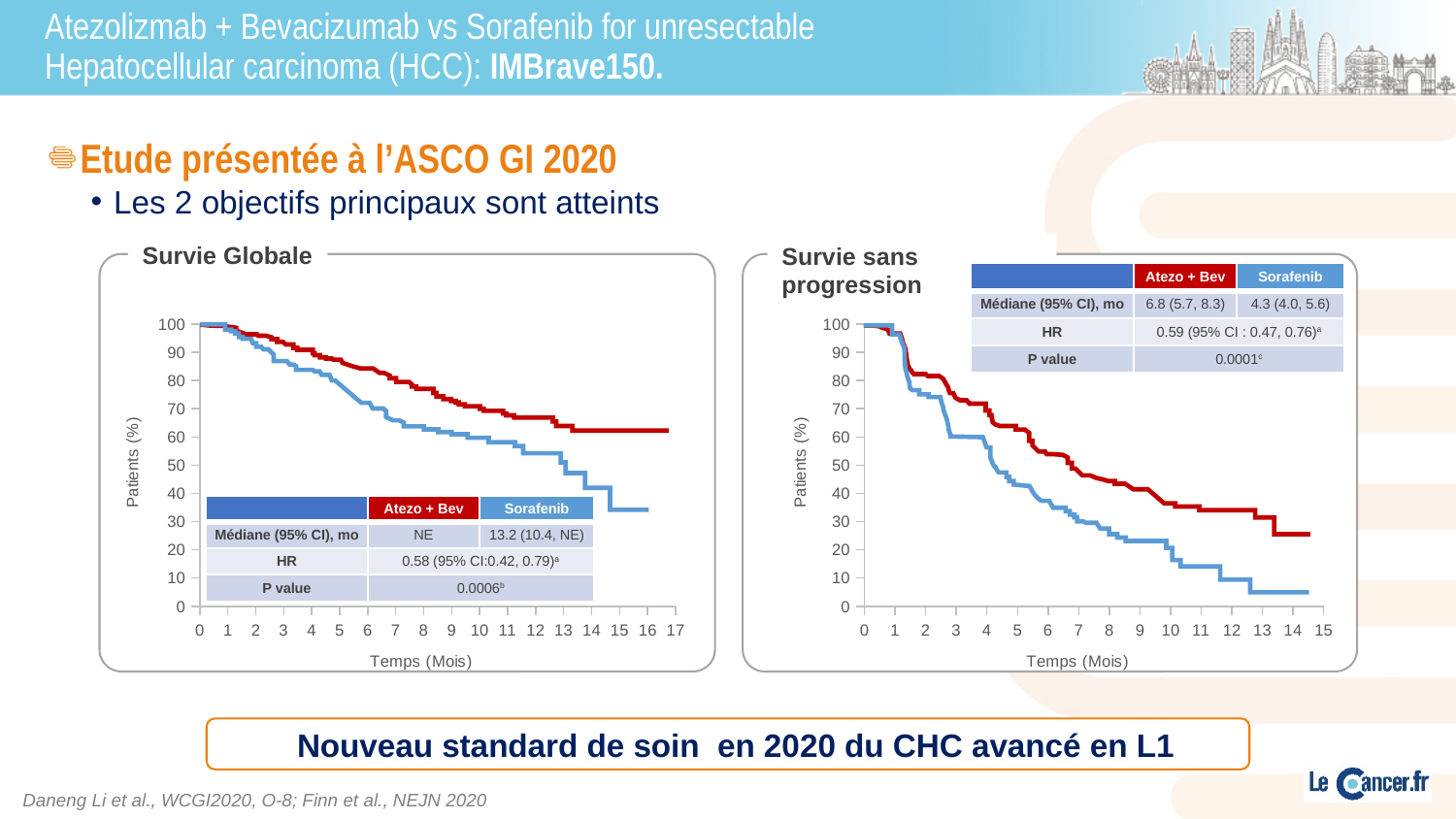
What is the label of the x axis in the Survie sans progression chart? Temps (Mois) In the Survie sans progression chart, what is the difference in median months between Atezo + Bev and Sorafenib? 2.5 In the Survie sans progression chart, is the Sorafenib curve at 12 months greater or less than 20? less In the Survie sans progression chart, what is the median (95% CI) in months for Sorafenib? 4.3 (4.0, 5.6) How many treatment arms are plotted in the Survie Globale chart? 2 In the Survie Globale chart, which arm has the higher curve at 12 months, Atezo + Bev or Sorafenib? Atezo + Bev In the Survie Globale chart, what is the median (95% CI) in months for Atezo + Bev? NE In the Survie Globale chart, what is the hazard ratio (HR) shown in the table? 0.58 (95% CI: 0.42, 0.79) In the Survie sans progression chart, what is the P value shown in the table? 0.0001 In the Survie Globale chart, what is the median overall survival (95% CI) in months for Sorafenib? 13.2 (10.4, NE) In the Survie Globale chart, what is the P value shown in the table? 0.0006 In the Survie sans progression chart, what is the median (95% CI) in months for Atezo + Bev? 6.8 (5.7, 8.3)